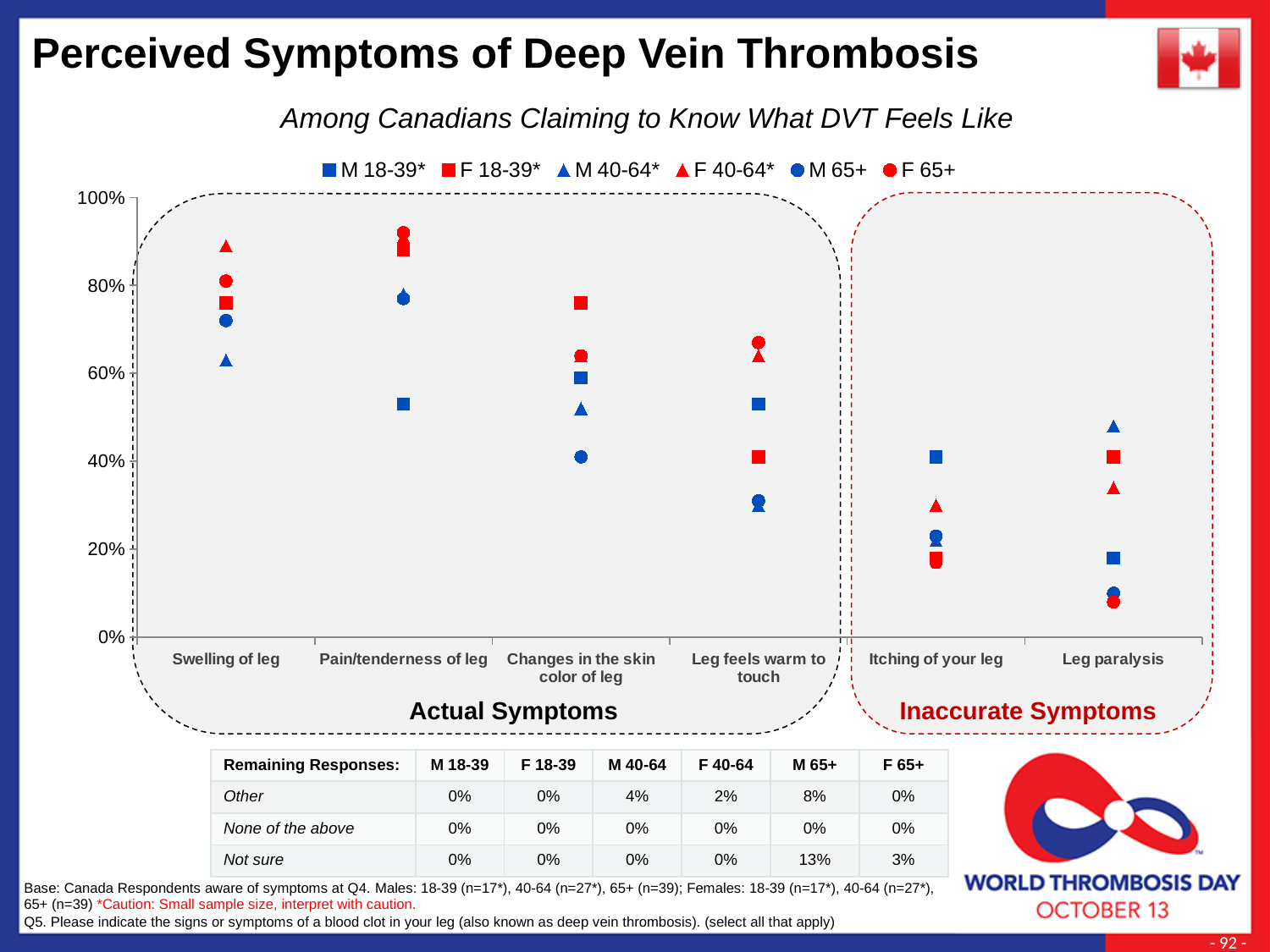
Is the value for F 18-39* for Changes in the skin color of leg greater or less than 60%? greater Which series has the lowest value for Changes in the skin color of leg? M 65+ What kind of chart is used to show the perceived symptoms of deep vein thrombosis? Scatter (dot) chart For Swelling of leg, which is larger: the value for F 40-64* or for M 40-64*? F 40-64* Which two symptom categories are grouped under the label 'Inaccurate Symptoms'? Itching of your leg and Leg paralysis Is the value for M 65+ for Leg paralysis greater or less than 20%? less Is the value for M 18-39* for Pain/tenderness of leg greater or less than 60%? less How many symptom categories are shown along the x axis? 6 For Itching of your leg, which is larger: the value for M 18-39* or for F 18-39*? M 18-39* How many series does the legend list? 6 Which series has the highest value for Leg paralysis? M 40-64*